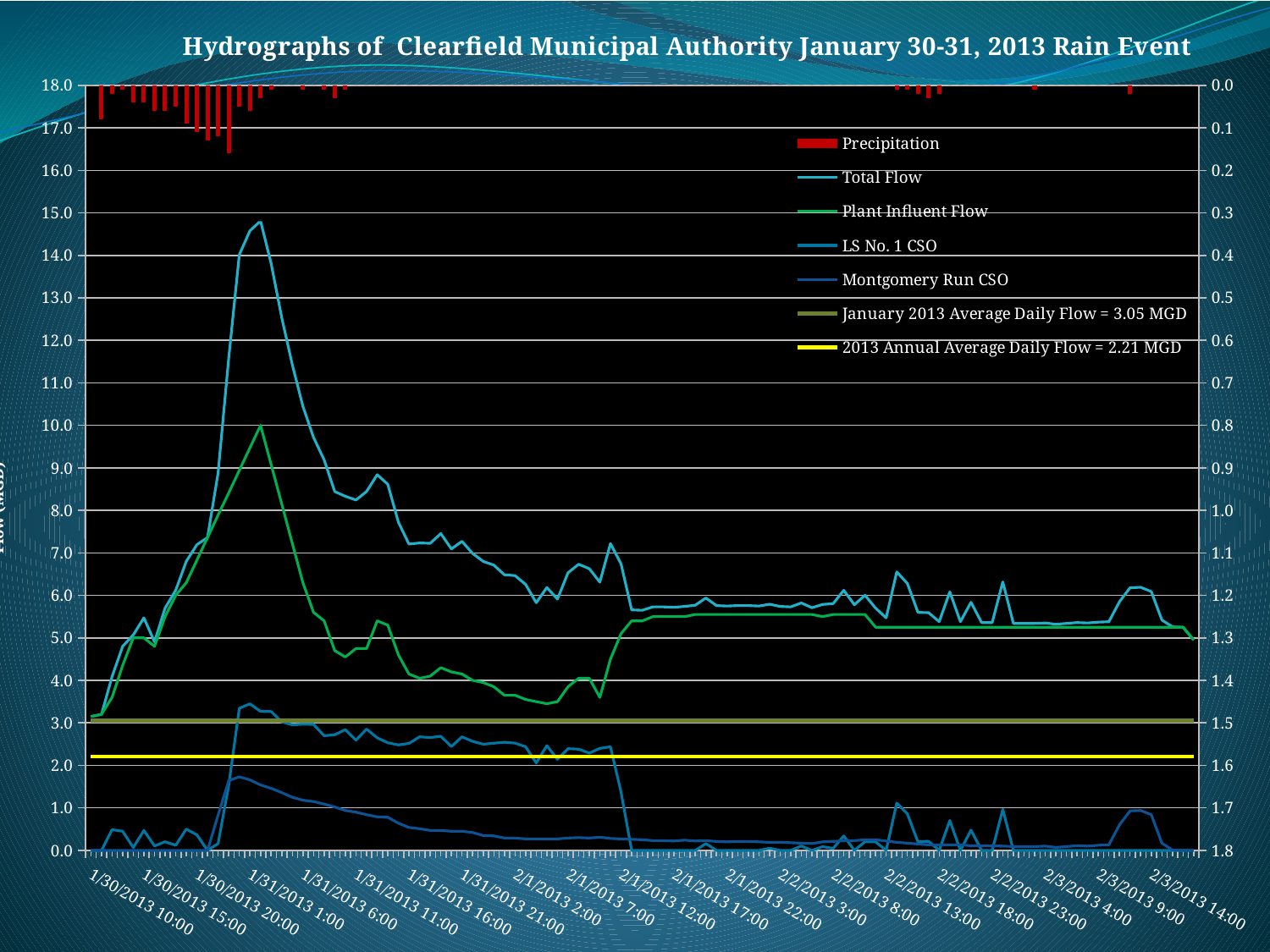
What colour is used for the Precipitation series in the legend? Red Which is larger, the January 2013 Average Daily Flow or the 2013 Annual Average Daily Flow? January 2013 Average Daily Flow At its peak, which is higher, Total Flow or Plant Influent Flow? Total Flow What is the January 2013 Average Daily Flow shown in the legend? 3.05 MGD What is the title of the chart? Hydrographs of Clearfield Municipal Authority January 30-31, 2013 Rain Event How many series does the legend list? 7 What is the difference between the January 2013 Average Daily Flow and the 2013 Annual Average Daily Flow? 0.84 MGD After its peak around 1/31/2013 1:00, does Total Flow rise or fall over the following hours? fall Which series reaches the highest value on the chart? Total Flow Is the peak value of Total Flow greater or less than 13.0? greater What is the 2013 Annual Average Daily Flow shown in the legend? 2.21 MGD Is the peak value of Plant Influent Flow greater or less than 9.0? greater